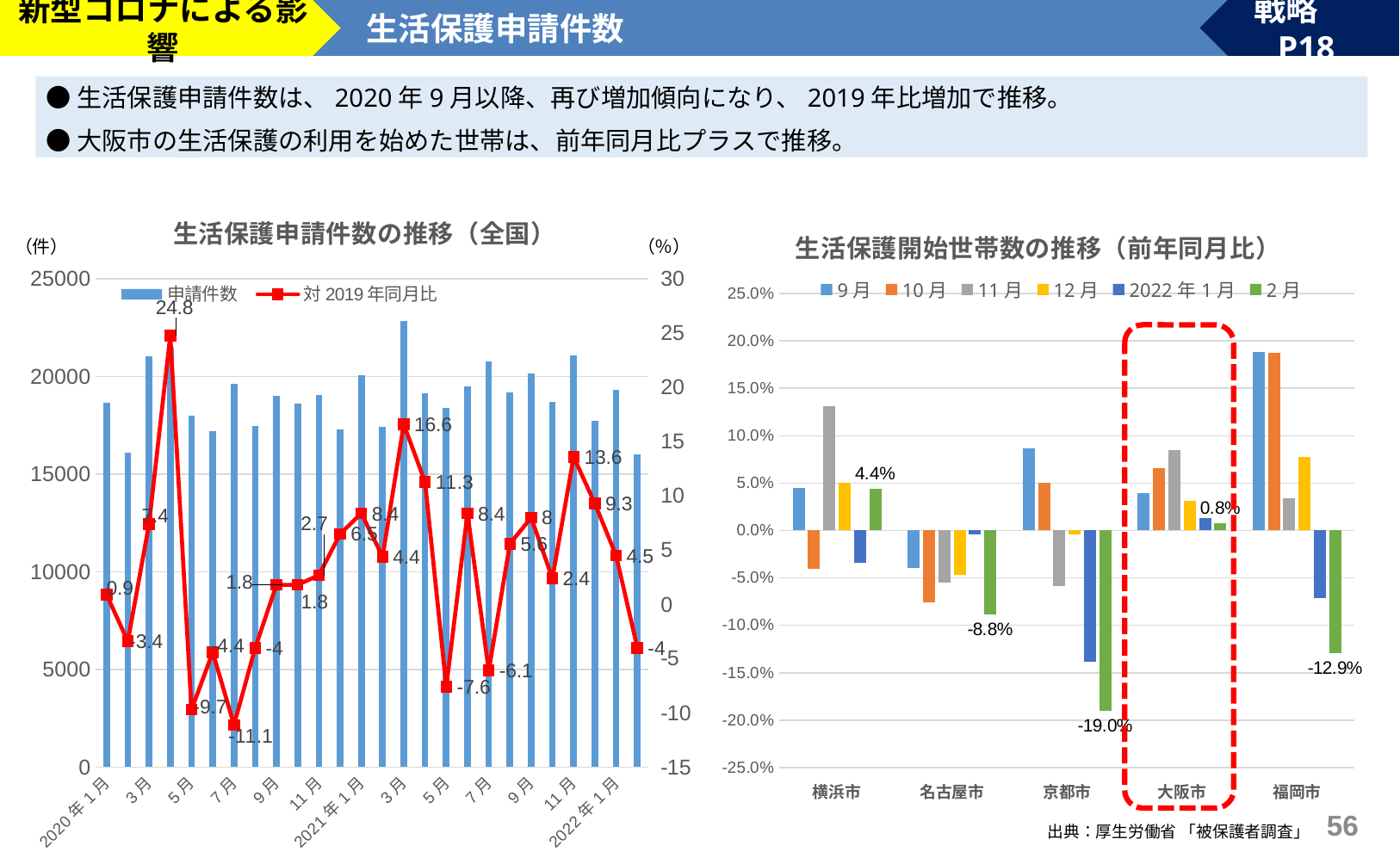
In the left chart 生活保護申請件数の推移（全国）, what is the 対2019年同月比 value for 2020年4月? 24.8 In the right chart 生活保護開始世帯数の推移（前年同月比）, what is the 2月 value for 京都市? -19.0% How many cities are shown on the x axis of the right chart 生活保護開始世帯数の推移（前年同月比）? 5 In the right chart 生活保護開始世帯数の推移（前年同月比）, is the 11月 value for 横浜市 greater or less than 10.0%? greater What kind of chart is the left chart titled 生活保護申請件数の推移（全国）? A combined bar and line chart In the left chart 生活保護申請件数の推移（全国）, which month has the highest 対2019年同月比 value? 2020年4月 How many series does the legend of the right chart 生活保護開始世帯数の推移（前年同月比）list? 6 In the left chart 生活保護申請件数の推移（全国）, what is the 対2019年同月比 value for 2022年2月? -4 In the left chart 生活保護申請件数の推移（全国）, which month has the lowest 対2019年同月比 value? 2020年7月 How many series does the legend of the left chart 生活保護申請件数の推移（全国）list? 2 In the left chart 生活保護申請件数の推移（全国）, what is the difference between the 対2019年同月比 values for 2021年3月 (16.6) and 2021年4月 (11.3)? 5.3 In the right chart 生活保護開始世帯数の推移（前年同月比）, what is the 2月 value for 大阪市? 0.8%